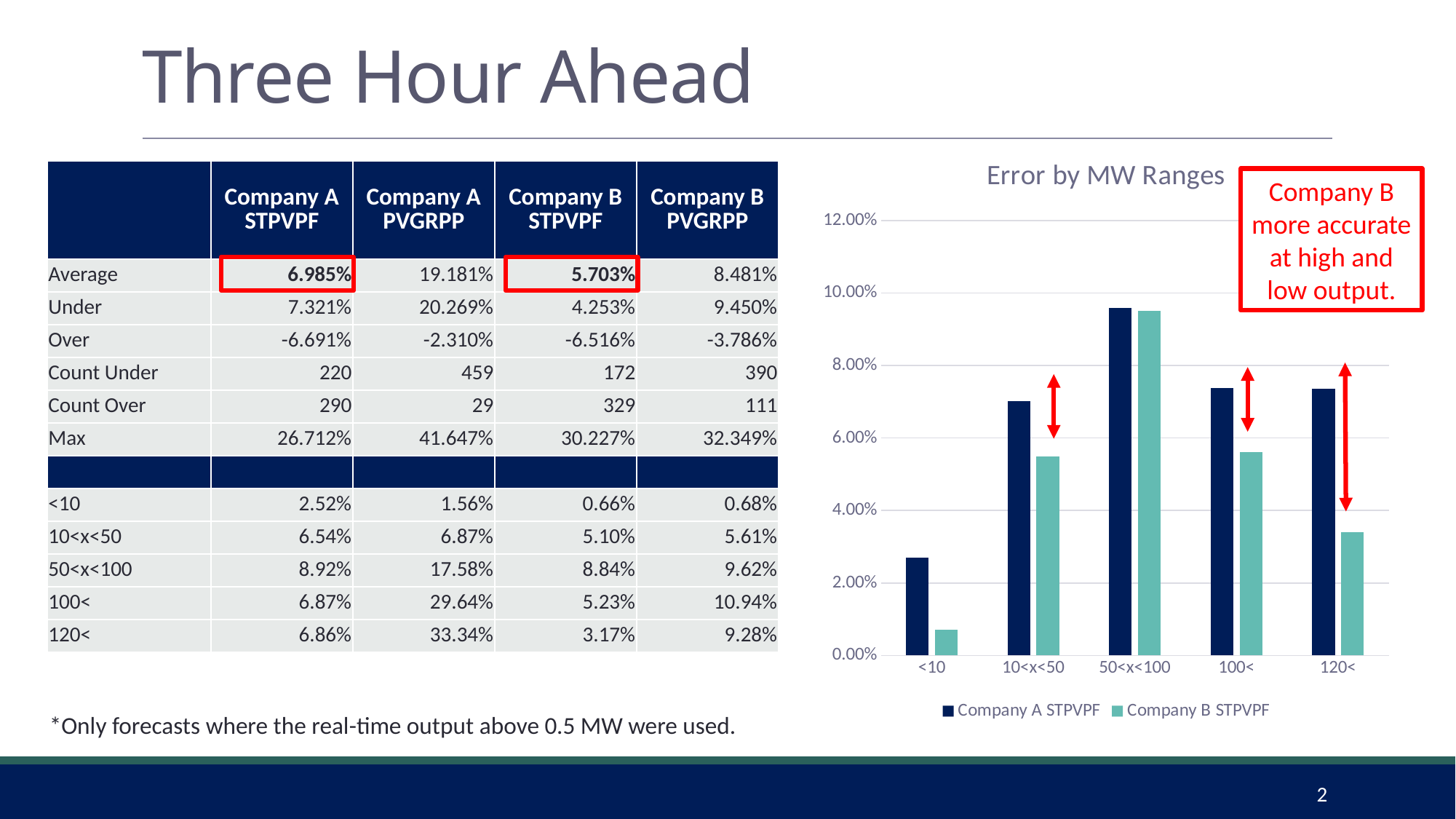
In the "Error by MW Ranges" chart, is the value for Company B STPVPF in the <10 range greater or less than 2.00%? less In the "Error by MW Ranges" chart, which MW range has the highest value for Company A STPVPF? 50<x<100 In the "Error by MW Ranges" chart, is the value for Company A STPVPF in the 50<x<100 range greater or less than 8.00%? greater What kind of chart is "Error by MW Ranges"? bar chart How many series does the legend of the "Error by MW Ranges" chart list? 2 In the "Error by MW Ranges" chart, for the <10 range, which series has the larger value: Company A STPVPF or Company B STPVPF? Company A STPVPF In the "Error by MW Ranges" chart, which MW range has the lowest value for Company B STPVPF? <10 In the "Error by MW Ranges" chart, which MW range has the highest value for Company B STPVPF? 50<x<100 In the "Error by MW Ranges" chart, is the value for Company B STPVPF in the 120< range greater or less than 4.00%? less In the "Error by MW Ranges" chart, for the 120< range, which series has the larger value: Company A STPVPF or Company B STPVPF? Company A STPVPF What is the title of the chart on the right side of the slide? Error by MW Ranges How many MW range categories are shown on the x axis of the "Error by MW Ranges" chart? 5